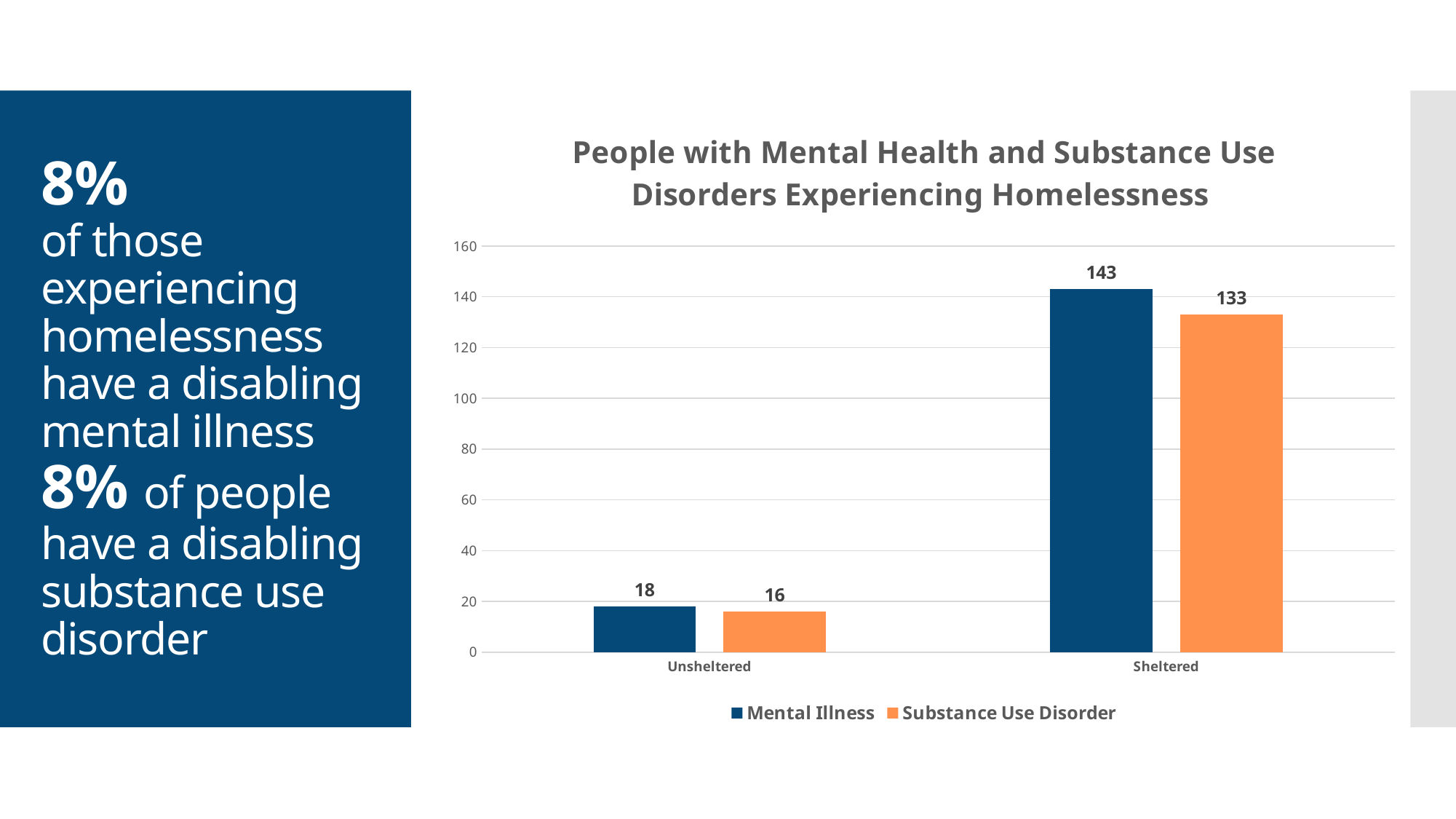
What is the Substance Use Disorder value for Sheltered? 133 How many series does the legend list? 2 What is the Mental Illness value for Unsheltered? 18 What kind of chart is shown on the slide? Bar chart What is the Substance Use Disorder value for Unsheltered? 16 What is the difference between the Mental Illness and Substance Use Disorder values for Sheltered? 10 What is the difference between the Sheltered and Unsheltered Mental Illness values? 125 How many categories are shown on the x axis? 2 Which is larger for Unsheltered: Mental Illness or Substance Use Disorder? Mental Illness Which category has the lowest Substance Use Disorder value? Unsheltered What is the Mental Illness value for Sheltered? 143 Which category has the highest Mental Illness value? Sheltered